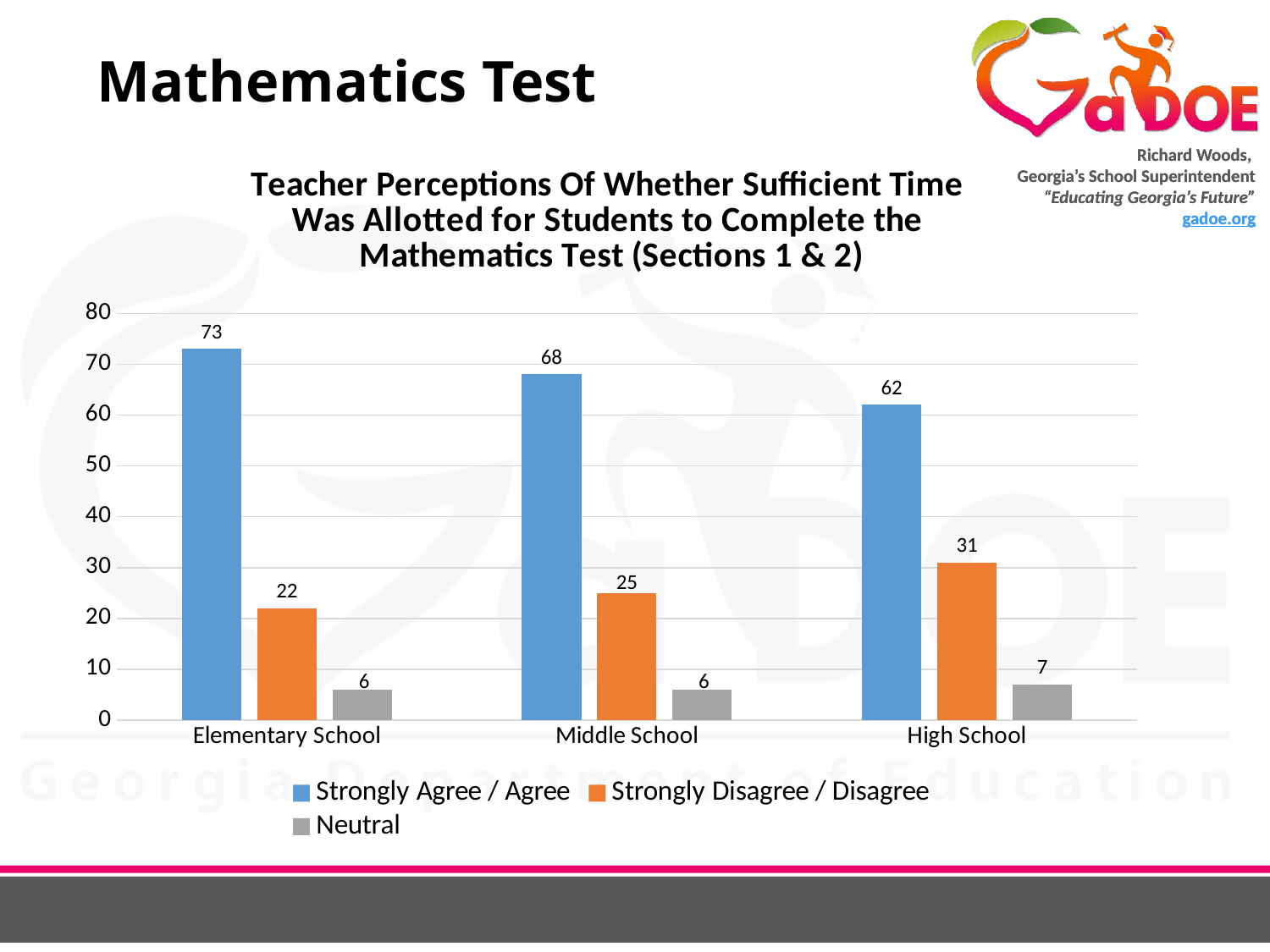
How many series does the legend list? 3 What is the Neutral value for Middle School? 6 What is the difference between the Strongly Agree / Agree values for Elementary School and High School? 11 What is the Strongly Disagree / Disagree value for High School? 31 What is the Strongly Agree / Agree value for Elementary School? 73 Which is larger: the Strongly Disagree / Disagree value for Middle School or for High School? High School Which school level has the lowest Strongly Disagree / Disagree value? Elementary School Which school level has the highest Strongly Agree / Agree value? Elementary School Do the Strongly Agree / Agree values rise or fall from Elementary School to High School? fall Is the Strongly Agree / Agree value for Middle School greater or less than 60? greater How many school levels are shown on the x axis? 3 What kind of chart is shown on the slide? bar chart